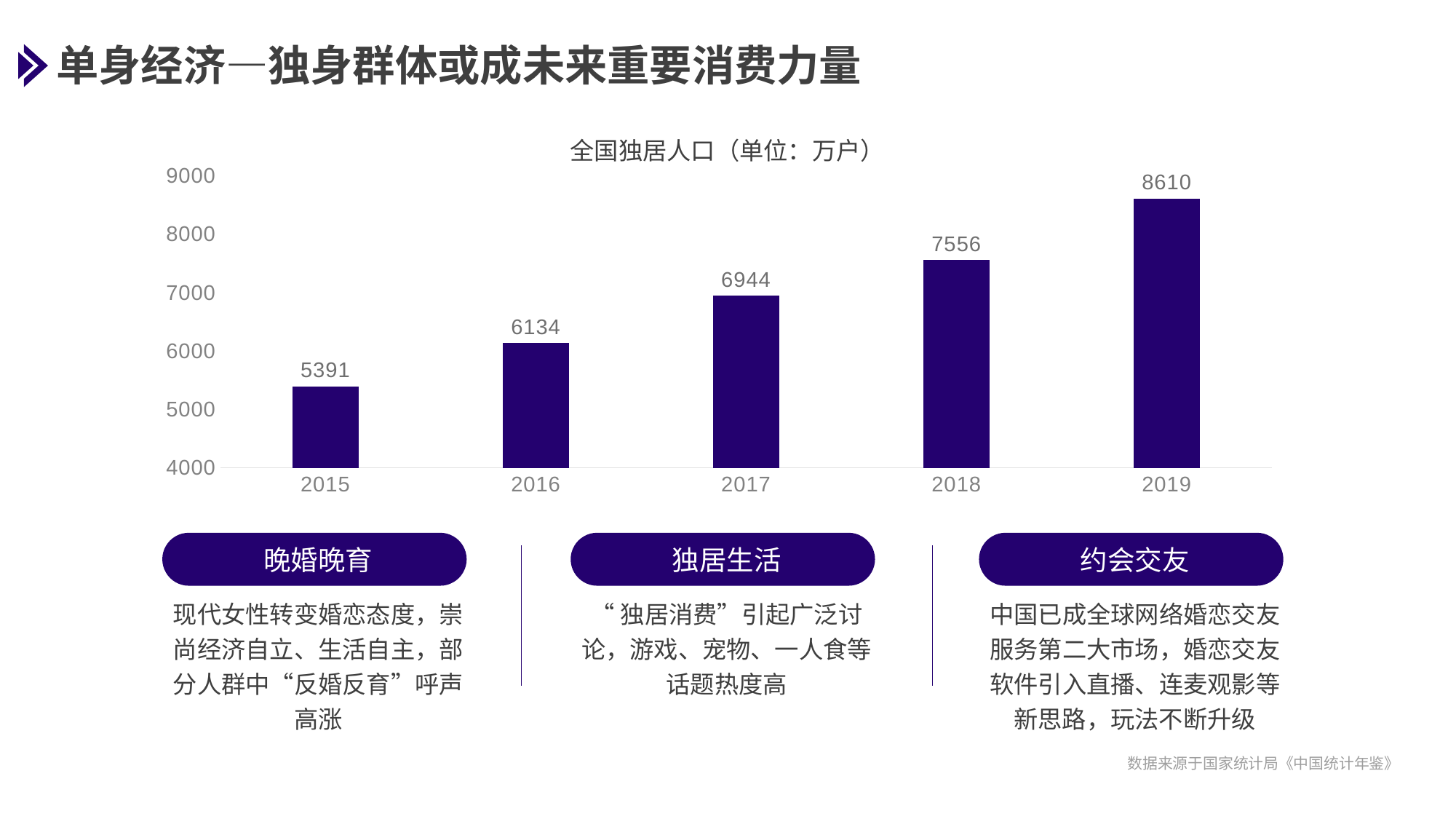
Is the value for 2018 greater or less than 7000? greater How many years are shown on the x axis? 5 What kind of chart is this? bar chart What is the difference between the values for 2019 and 2018? 1054 What is the value for 2017? 6944 Which is larger, the value for 2017 or the value for 2016? 2017 What is the difference between the values for 2016 and 2015? 743 Which year has the lowest value? 2015 What is the value for 2019? 8610 Which year has the highest value? 2019 Do the values rise or fall from 2015 to 2019? rise What is the value for 2015? 5391